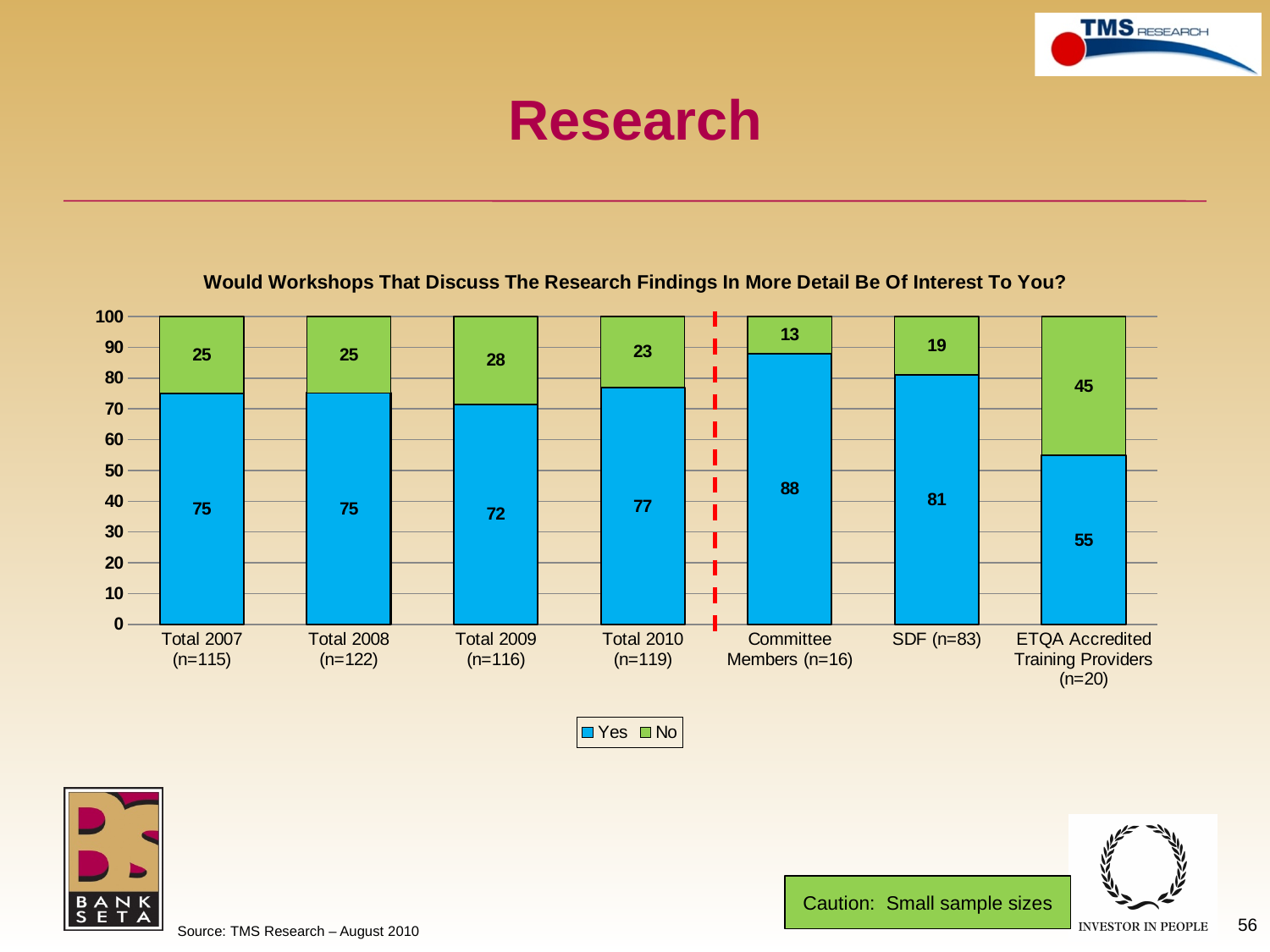
What kind of chart is this? Stacked bar chart What is the title of the chart? Would Workshops That Discuss The Research Findings In More Detail Be Of Interest To You? What is the No value for ETQA Accredited Training Providers (n=20)? 45 What is the Yes value for Committee Members (n=16)? 88 How many categories are shown on the x axis? 7 Which is larger, the No value for Total 2009 (n=116) or the No value for Total 2010 (n=119)? Total 2009 (n=116) What is the total of the stacked bar for SDF (n=83)? 100 Which category has the highest Yes value? Committee Members (n=16) Which category has the lowest Yes value? ETQA Accredited Training Providers (n=20) What is the difference between the Yes values for SDF (n=83) and Total 2010 (n=119)? 4 What is the Yes value for Total 2009 (n=116)? 72 How many series does the legend list? 2